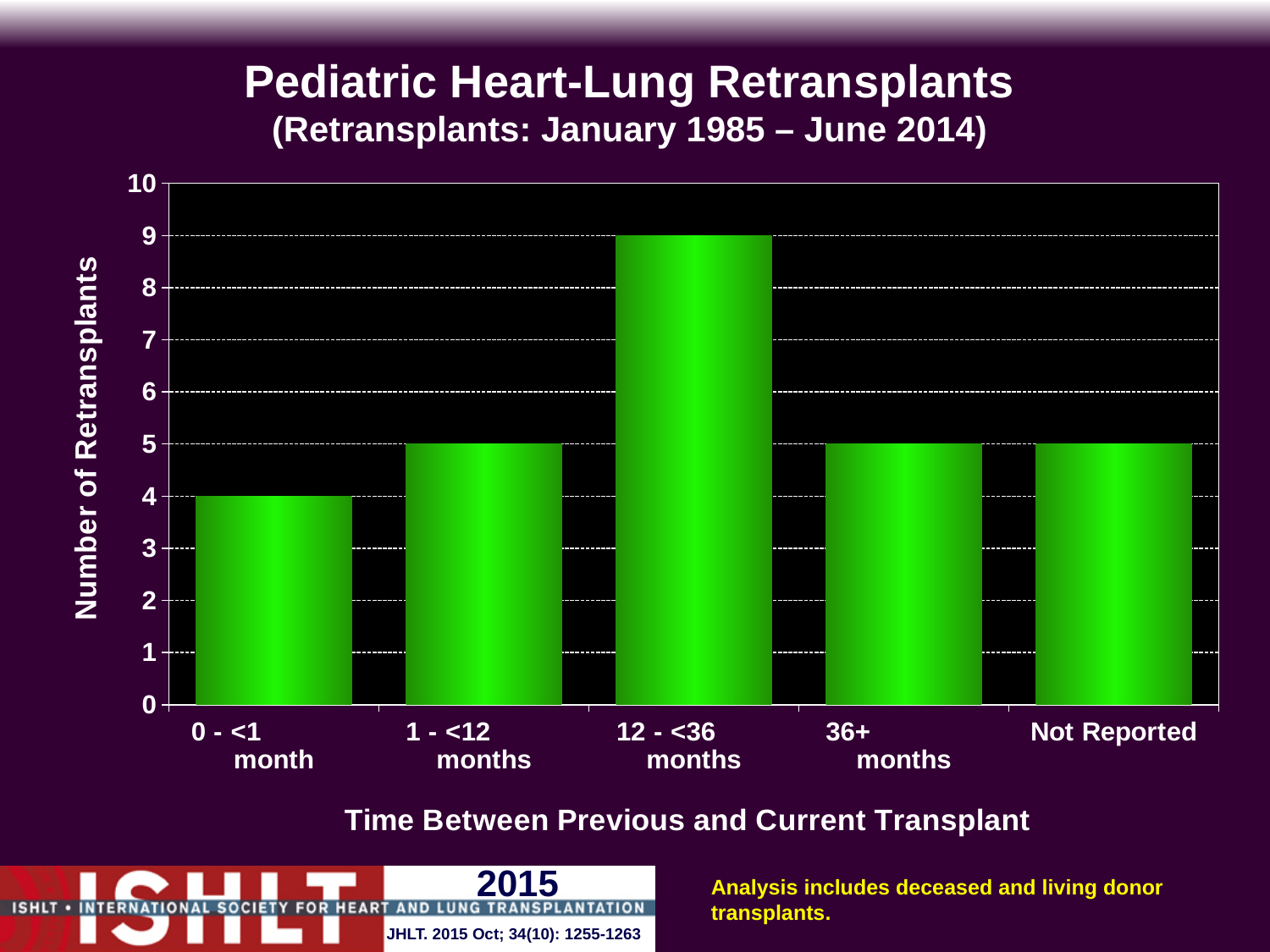
What is the label of the x axis? Time Between Previous and Current Transplant What type of chart is shown on the slide? bar chart Which time-between-transplant category has the lowest number of retransplants? 0 - <1 month What is the label of the y axis? Number of Retransplants How many retransplants are shown for the 36+ months category? 5 How many retransplants are shown for the 12 - <36 months category? 9 What is the difference in number of retransplants between the 12 - <36 months and 0 - <1 month categories? 5 Which has more retransplants: 1 - <12 months or 0 - <1 month? 1 - <12 months How many retransplants are shown for the 0 - <1 month category? 4 Which time-between-transplant category has the highest number of retransplants? 12 - <36 months How many retransplants are shown for the Not Reported category? 5 How many categories are shown on the x axis? 5